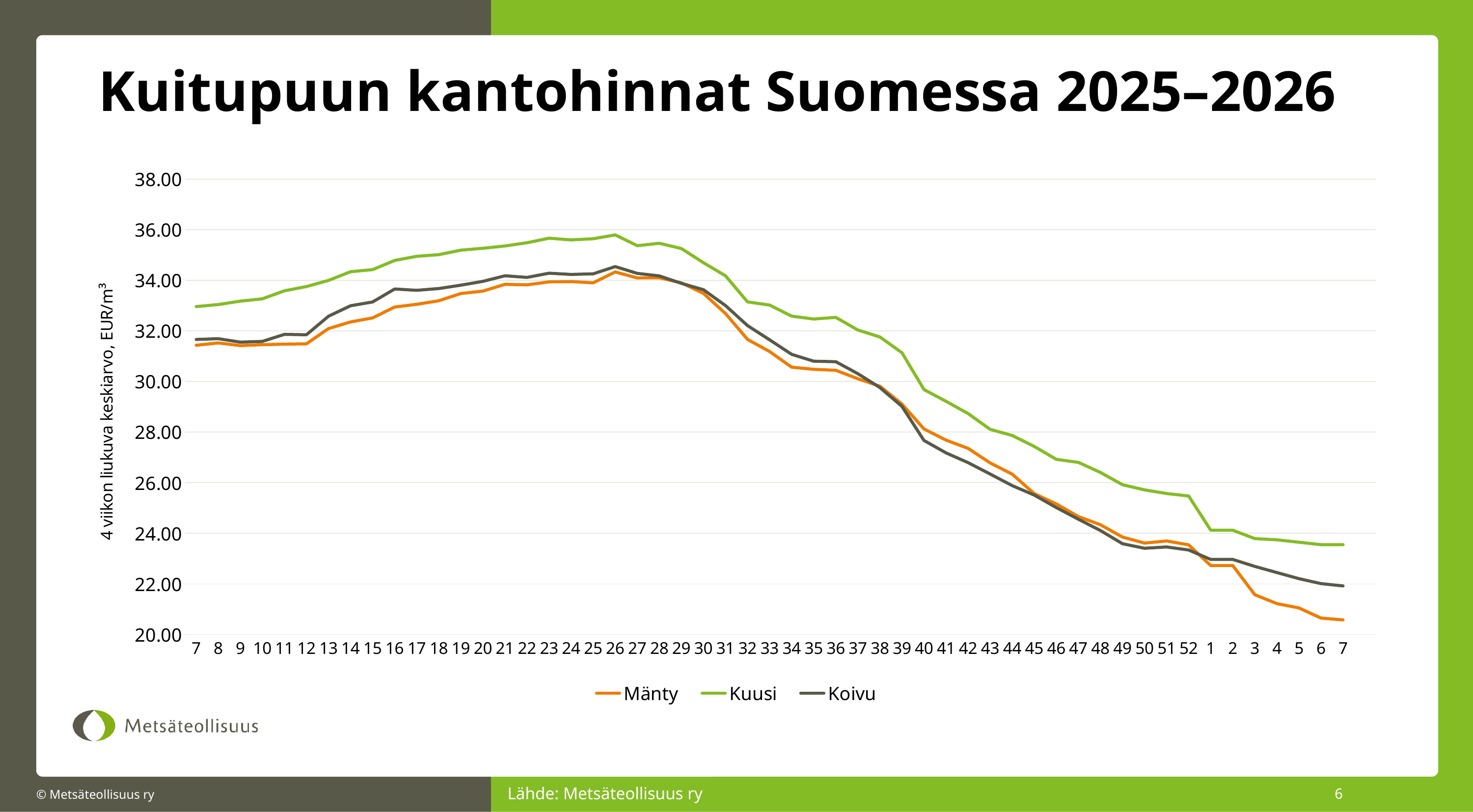
Do the values for Mänty rise or fall from week 30 to the final week 7? fall Is the value for Kuusi at week 26 greater or less than 34.00? greater At week 16, which is higher, Koivu or Mänty? Koivu Which series are listed in the legend? Mänty, Kuusi, Koivu What is the title of the chart on the slide? Kuitupuun kantohinnat Suomessa 2025–2026 Which series has the lowest value at the final week 7 on the right of the chart? Mänty Which series has the highest value at week 26? Kuusi What kind of chart is shown on the slide? line chart Is the value for Kuusi at the first week 7 on the left greater or less than 32.00? greater Is the value for Mänty at the final week 7 on the right greater or less than 22.00? less How many weekly points are plotted along the x axis? 53 How many series does the legend list? 3